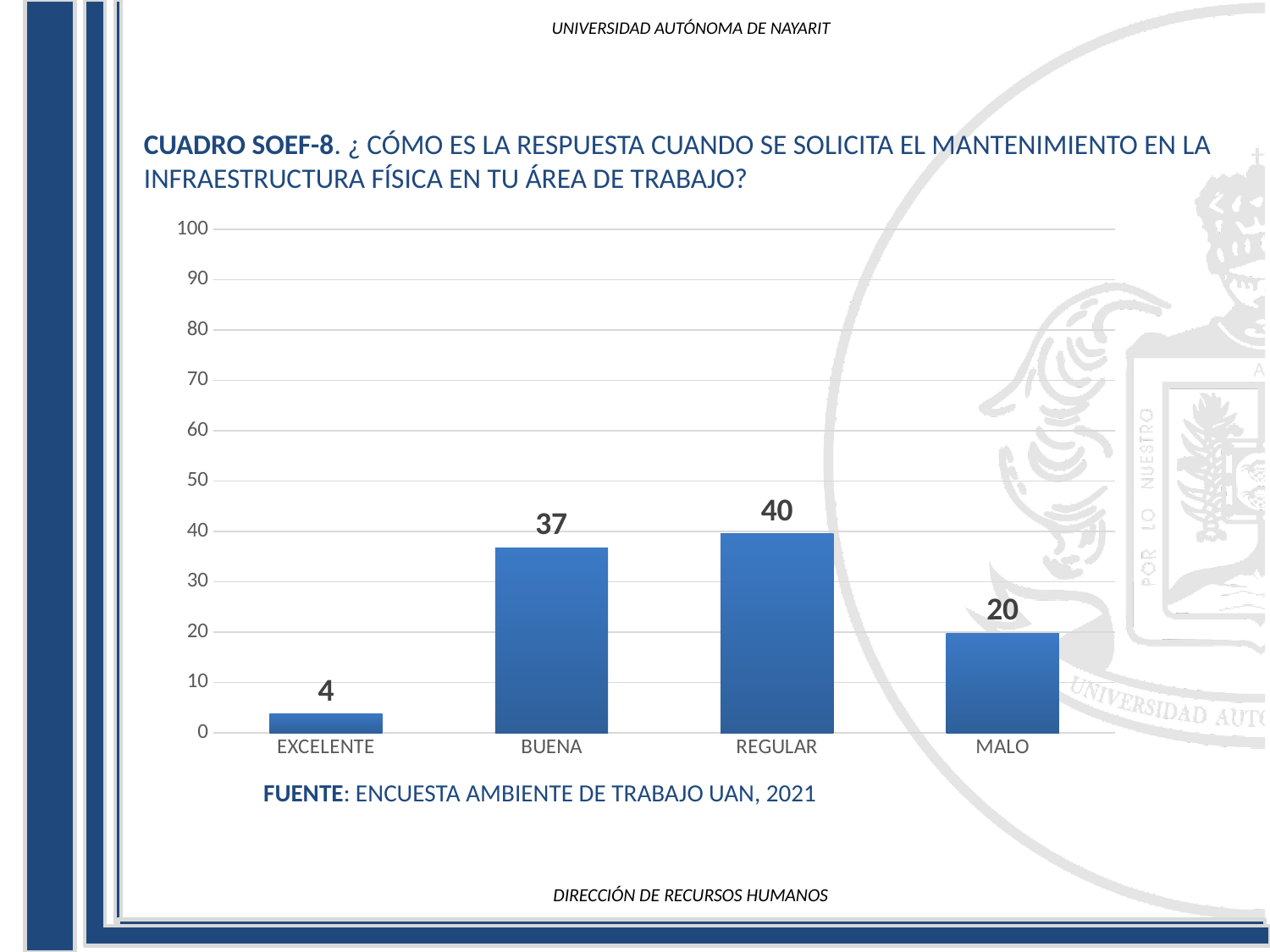
What kind of chart is shown on the slide? Bar chart What is the value for MALO? 20 Which category has the lowest value? EXCELENTE What is the difference between the values for REGULAR and BUENA? 3 What is the value for BUENA? 37 What is the value for REGULAR? 40 Which is larger, the value for BUENA or the value for MALO? BUENA What is the value for EXCELENTE? 4 What is the difference between the values for MALO and EXCELENTE? 16 What is the source cited below the chart? ENCUESTA AMBIENTE DE TRABAJO UAN, 2021 How many categories are shown on the x axis? 4 Which category has the highest value? REGULAR